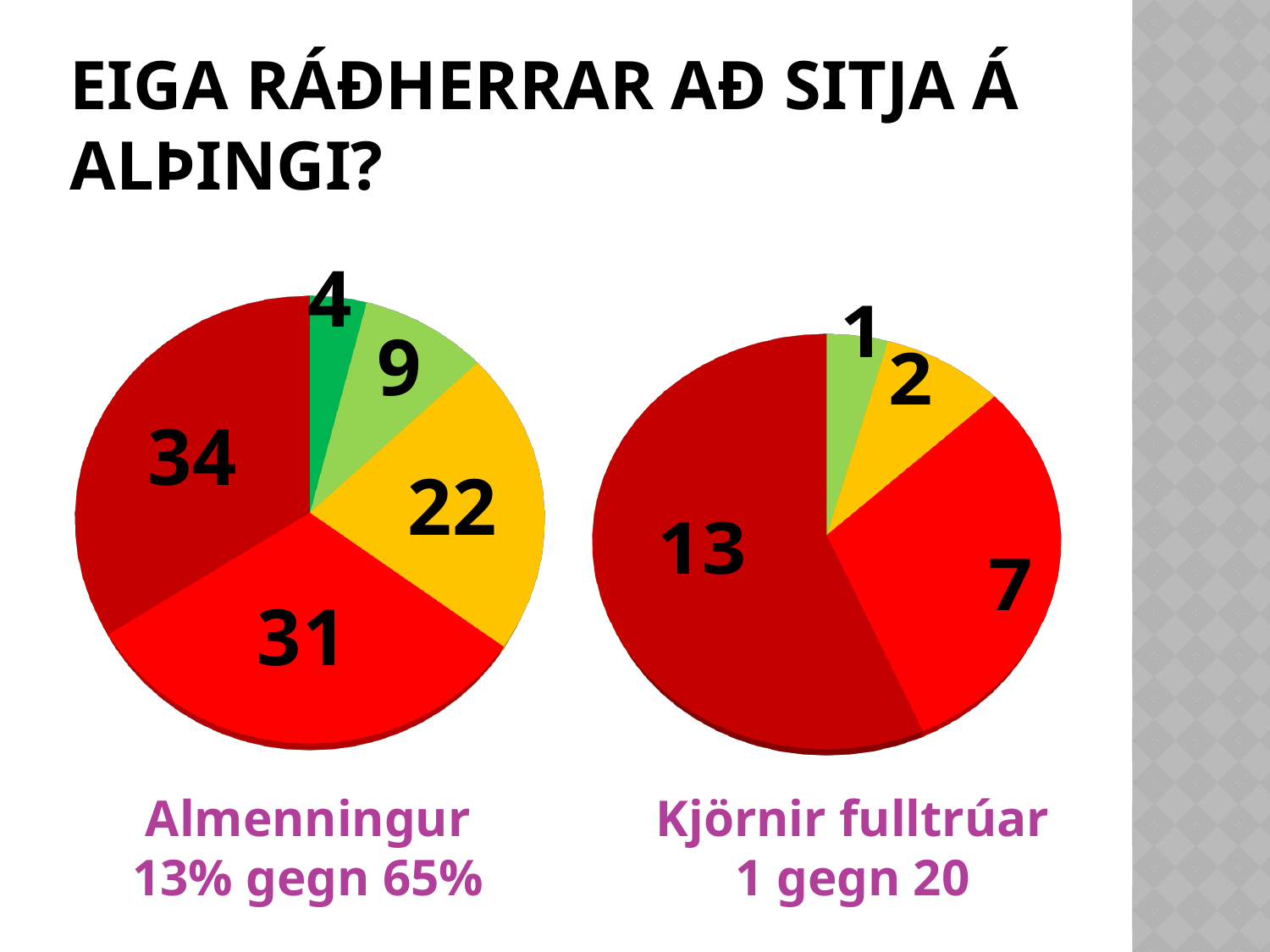
How many slices does the "Almenningur" pie chart have? 5 In the "Almenningur" pie chart, what is the value of the largest slice? 34 In the "Almenningur" pie chart, which slice is larger: the yellow slice or the light green slice? the yellow slice In the "Almenningur" pie chart, what value is shown on the yellow slice? 22 In the "Kjörnir fulltrúar" pie chart, what is the difference between the dark red slice (13) and the bright red slice (7)? 6 In the "Kjörnir fulltrúar" pie chart, what is the value of the smallest slice? 1 In the "Almenningur" pie chart, what is the difference between the dark red slice (34) and the bright red slice (31)? 3 How many slices does the "Kjörnir fulltrúar" pie chart have? 4 What kind of chart is the "Almenningur" chart on the left? pie chart What caption is printed below the "Almenningur" pie chart? 13% gegn 65% In the "Kjörnir fulltrúar" pie chart, what value is shown on the bright red slice? 7 What is the total of all slice values in the "Kjörnir fulltrúar" pie chart? 23